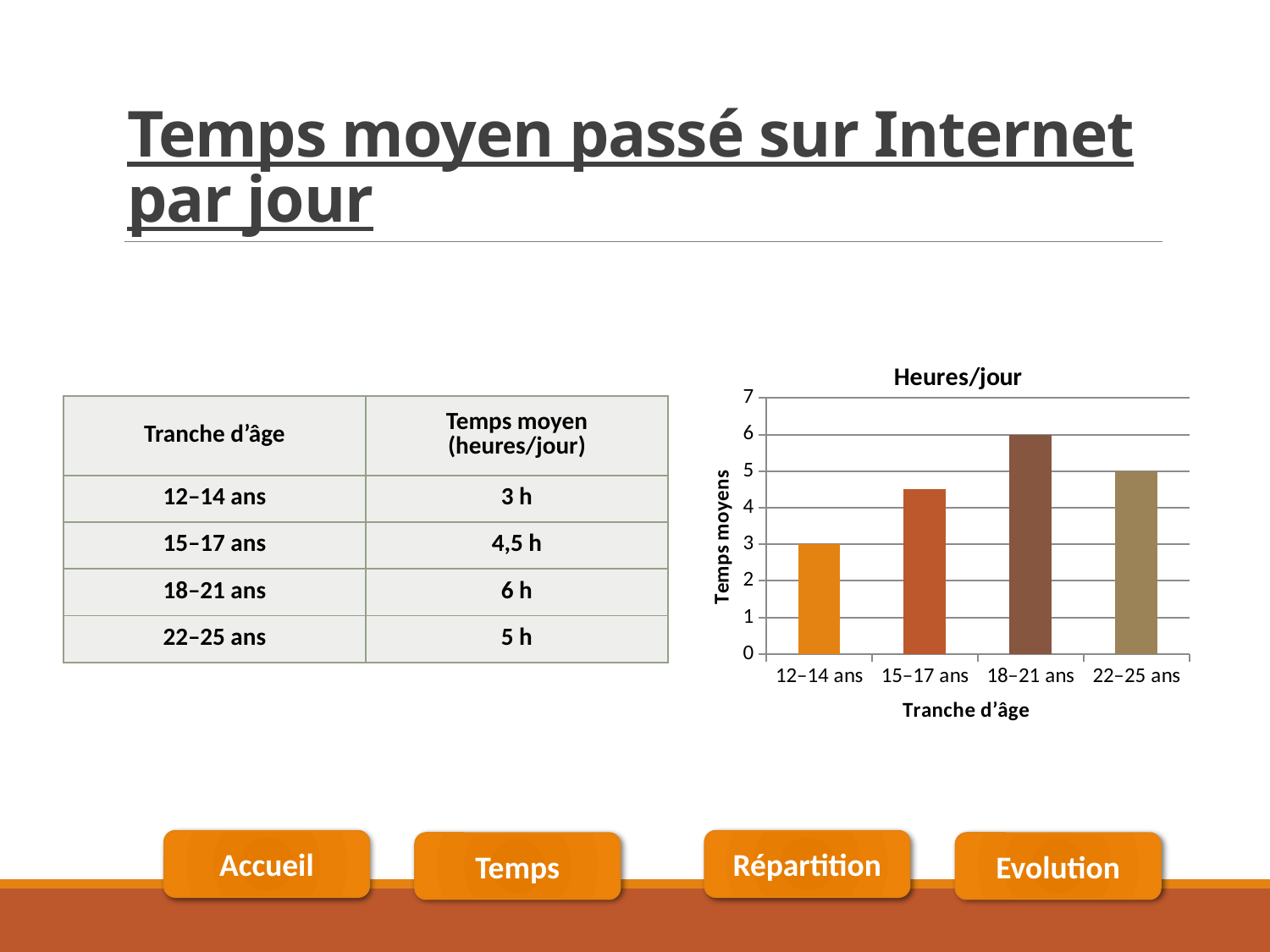
What kind of chart is shown on the slide? bar chart What is the label of the vertical axis? Temps moyens Which age group has the highest value? 18–21 ans How many age groups are plotted in the chart? 4 What is the value for 22–25 ans? 5 h Which age group has the lowest value? 12–14 ans What is the value for 15–17 ans? 4,5 h What is the difference between the values for 18–21 ans and 12–14 ans? 3 h Which is larger, the value for 22–25 ans or the value for 15–17 ans? 22–25 ans What is the title of the chart? Heures/jour What is the value for 12–14 ans? 3 h What is the value for 18–21 ans? 6 h